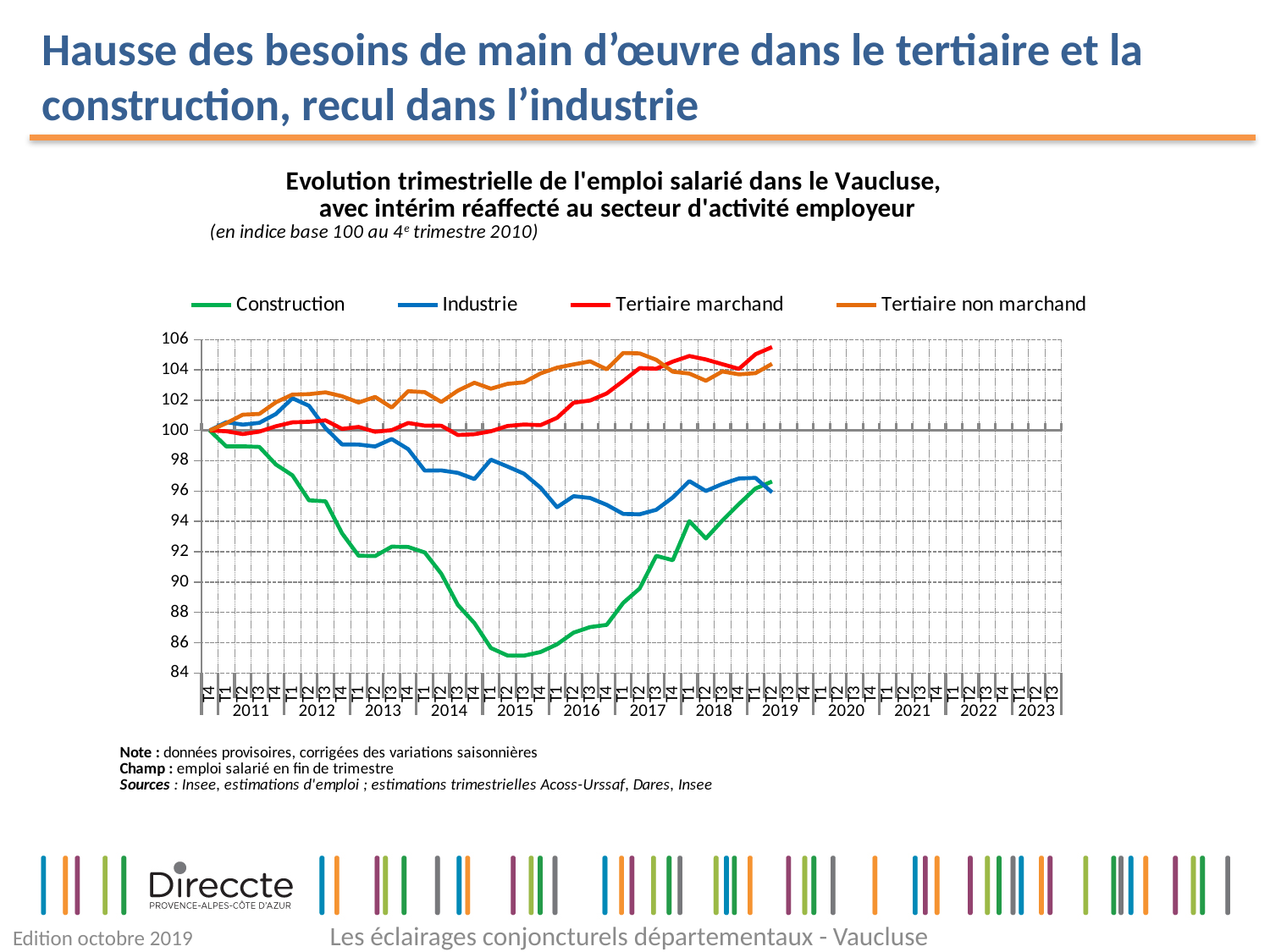
Does the Tertiaire non marchand series rise or fall between 2011 and 2017? rise What kind of chart is shown on the slide? line chart At T1 2013, which series is higher: Industrie or Construction? Industrie How many series does the legend list? 4 Is the value for Tertiaire marchand at T2 2019 greater or less than 104? greater Is the value for Tertiaire non marchand at T1 2017 greater or less than 104? greater Does the Construction series rise or fall between 2011 and 2015? fall What colour is the Construction line in the chart? green Which series has the lowest values over the period shown? Construction Is the value for Construction at T2 2015 greater or less than 86? less